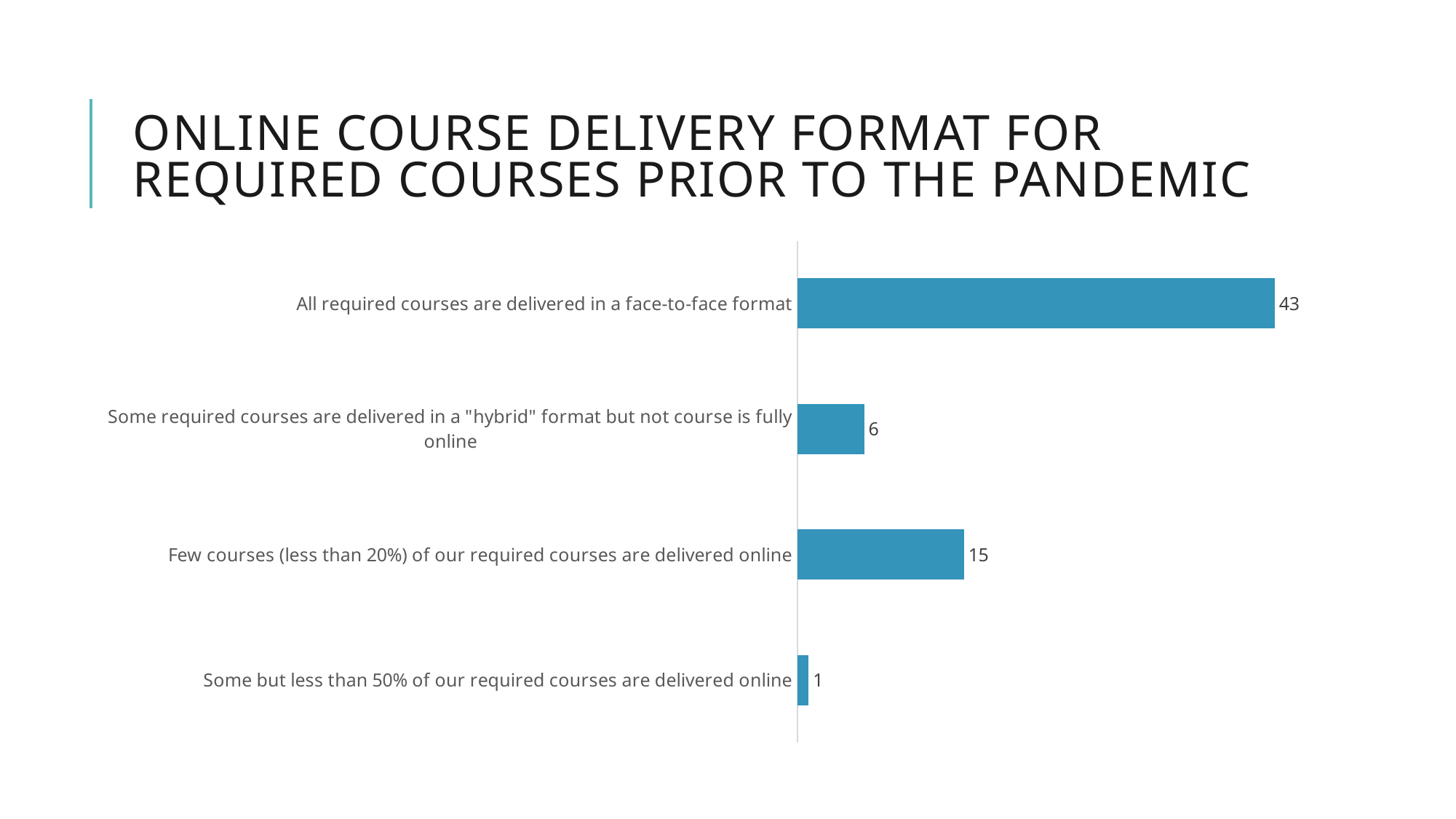
What is the difference between the value for "All required courses are delivered in a face-to-face format" and the value for "Few courses (less than 20%) of our required courses are delivered online"? 28 What is the difference between the value for "Few courses (less than 20%) of our required courses are delivered online" and the value for the "hybrid" format category? 9 What kind of chart is shown on the slide? Bar chart What is the value for "Few courses (less than 20%) of our required courses are delivered online"? 15 Which category has the highest value? All required courses are delivered in a face-to-face format What is the title of the slide? Online Course Delivery Format for Required Courses Prior to the Pandemic How many categories are shown in the chart? 4 What is the value for "All required courses are delivered in a face-to-face format"? 43 Which category has the lowest value? Some but less than 50% of our required courses are delivered online What is the value for "Some but less than 50% of our required courses are delivered online"? 1 Which is larger: the value for the "hybrid" format category or the value for "Few courses (less than 20%) of our required courses are delivered online"? Few courses (less than 20%) of our required courses are delivered online What is the value for "Some required courses are delivered in a "hybrid" format but not course is fully online"? 6